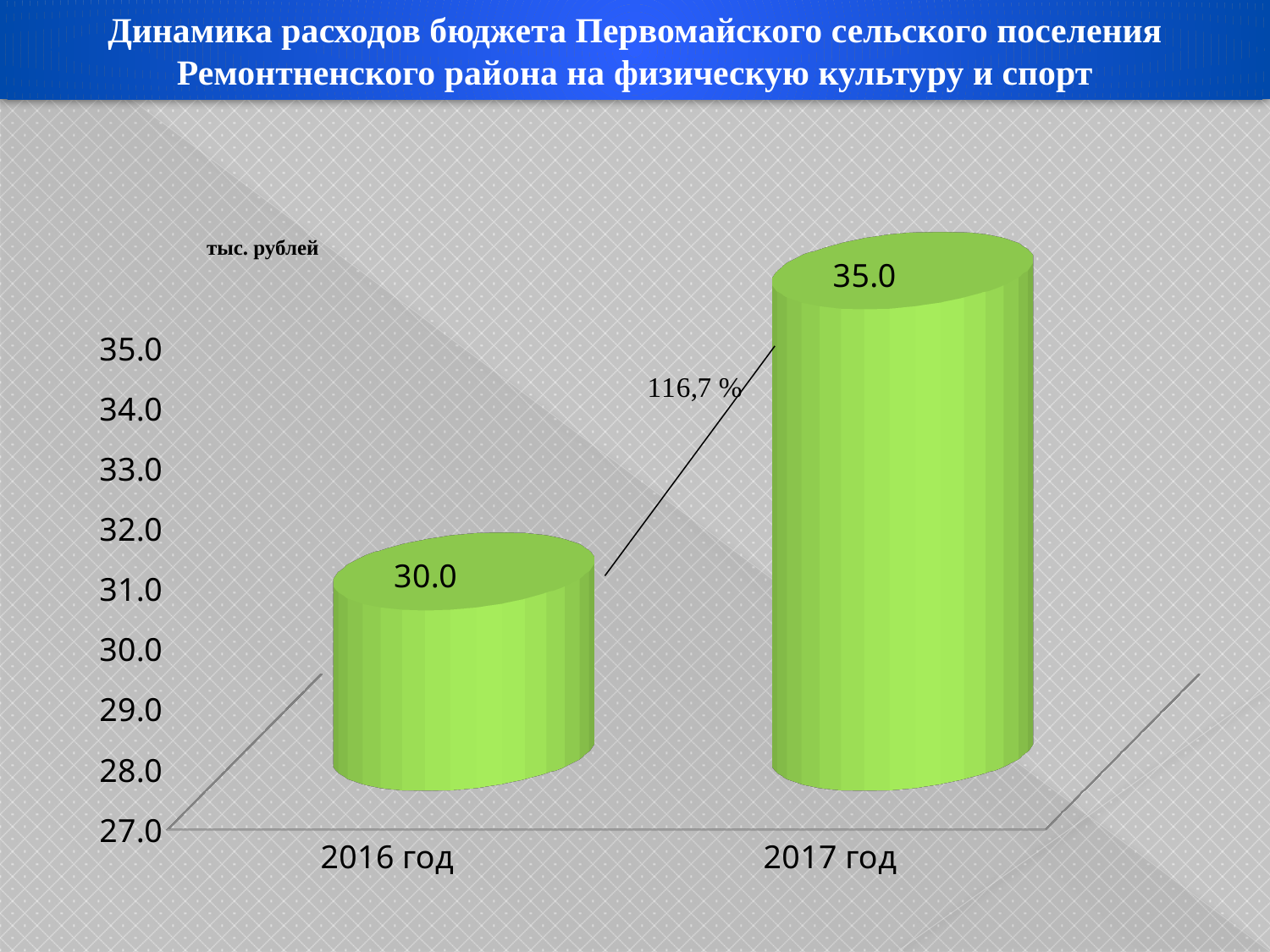
Is the value for 2016 год greater or less than 32.0? less What unit label is shown above the chart? тыс. рублей What is the value for 2016 год? 30.0 What kind of chart is shown on the slide? bar chart Do the values rise or fall from 2016 год to 2017 год? rise Which is larger, the value for 2016 год or 2017 год? 2017 год What percentage is shown on the line connecting the two bars? 116,7 % How many categories are shown on the x axis? 2 What is the value for 2017 год? 35.0 What is the difference between the values for 2017 год and 2016 год? 5.0 Which year has the lowest value? 2016 год Which year has the highest value? 2017 год